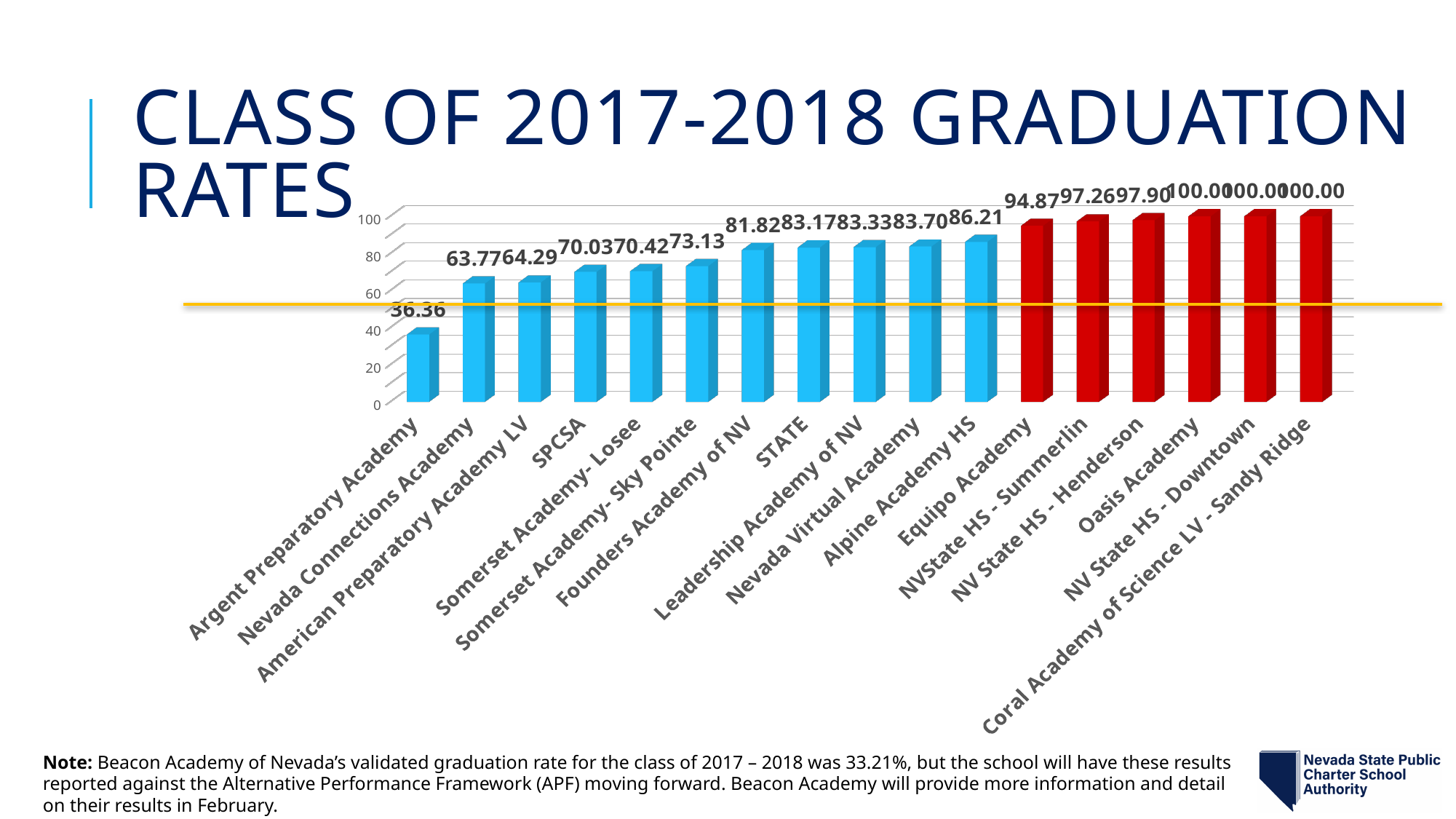
How many schools on the chart show a graduation rate of 100.00? 3 What is the value shown for NV State HS - Henderson? 97.90 What is the graduation rate shown for Equipo Academy? 94.87 Which school has the lowest graduation rate on the chart? Argent Preparatory Academy Which is larger, the value for SPCSA or the value for Founders Academy of NV? Founders Academy of NV What is the difference between the values for Nevada Connections Academy and Argent Preparatory Academy? 27.41 What is the difference between the values for Equipo Academy and Alpine Academy HS? 8.66 What is the graduation rate shown for Argent Preparatory Academy? 36.36 How many categories are plotted on the chart? 17 What kind of chart is shown on the slide? Bar chart What is the value shown for STATE? 83.17 Do the values rise or fall moving from left to right along the x axis? Rise